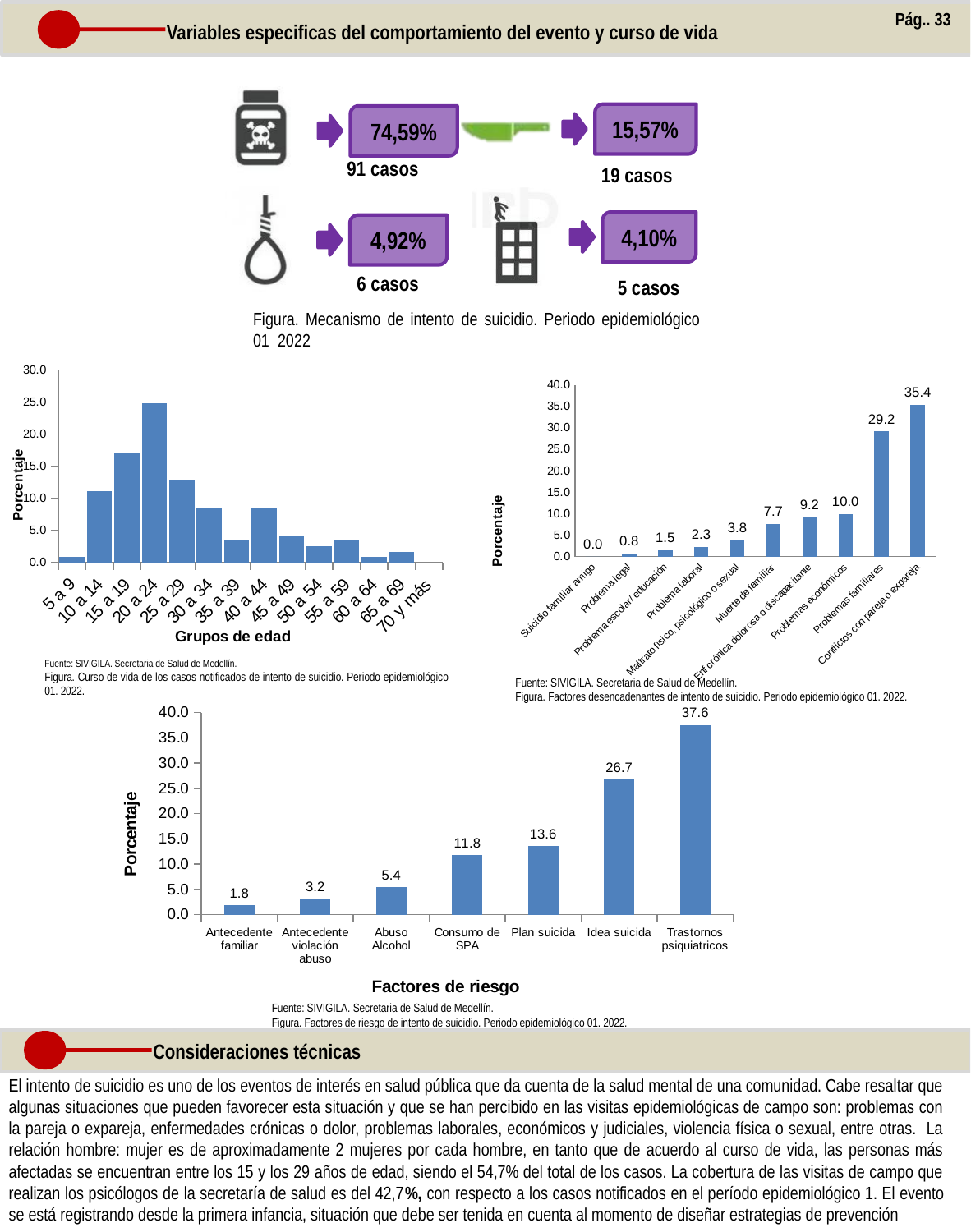
In the 'Factores de riesgo' chart at the bottom, what is the value for Consumo de SPA? 11.8 In the 'Factores de riesgo' chart at the bottom, what is the value for Trastornos psiquiatricos? 37.6 In the 'Factores de riesgo' chart at the bottom, which category has the lowest value? Antecedente familiar In the 'Factores desencadenantes' chart on the right, which is larger: Problemas económicos or Enf crónica dolorosa o discapacitante? Problemas económicos In the 'Factores desencadenantes' chart on the right, what is the value for Problemas familiares? 29.2 What kind of chart is the 'Grupos de edad' chart on the left? bar chart In the 'Factores de riesgo' chart at the bottom, how many categories are shown on the x axis? 7 In the 'Grupos de edad' chart on the left, which age group has the highest percentage? 20 a 24 In the 'Factores desencadenantes' chart on the right, which category has the highest value? Conflictos con pareja o expareja In the 'Factores de riesgo' chart at the bottom, what is the difference between Idea suicida and Plan suicida? 13.1 In the 'Grupos de edad' chart on the left, is the value for 15 a 19 greater or less than 15.0? greater In the 'Factores desencadenantes' chart on the right, what is the value for Muerte de familiar? 7.7